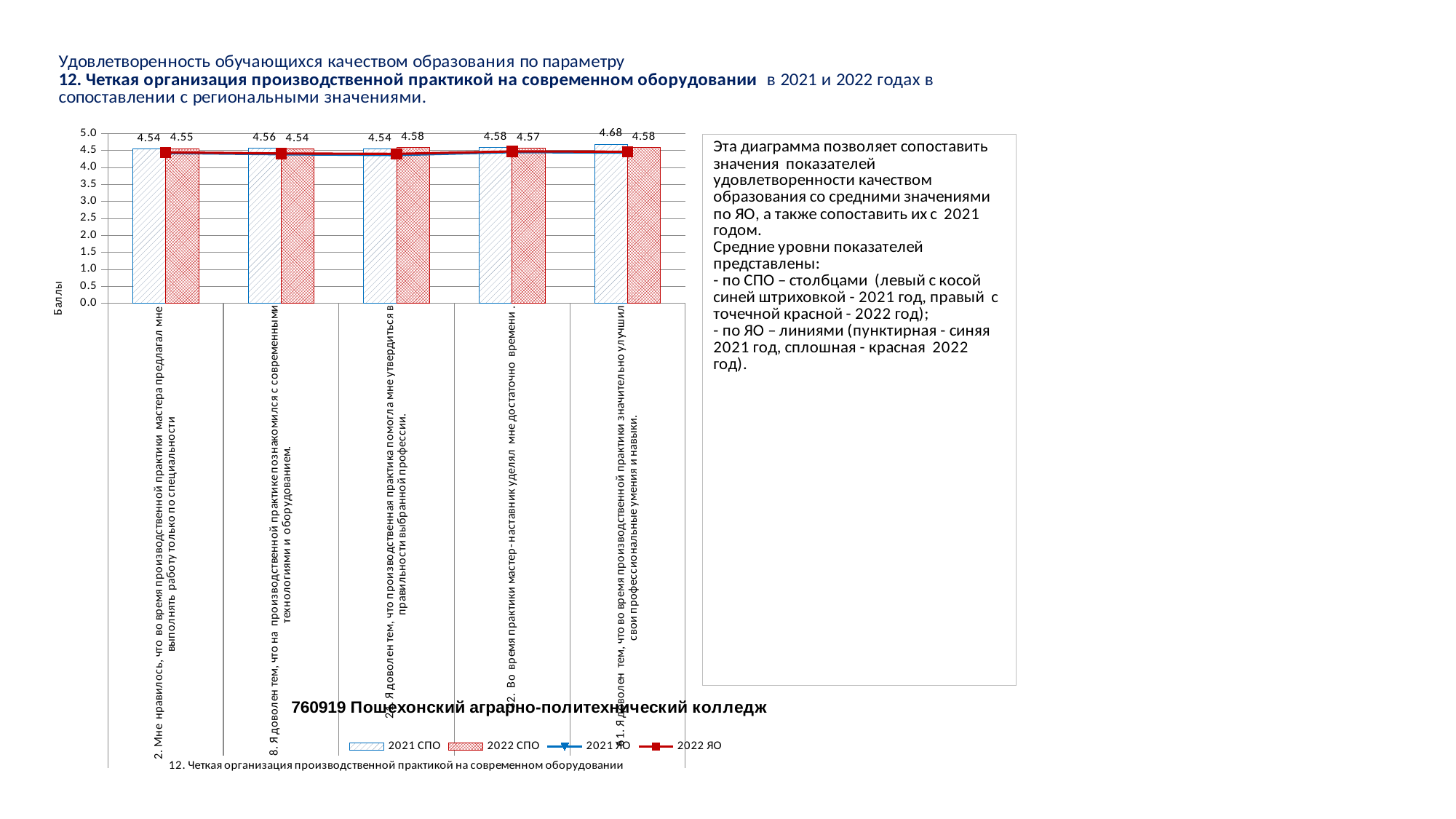
Which item has the highest 2021 СПО value? 61. Я доволен тем, что во время производственной практики значительно улучшил свои профессиональные умения и навыки What is the 2022 СПО value for item 2 (Мне нравилось, что во время производственной практики мастер предлагал мне выполнять работу только по специальности)? 4.55 What is the 2021 СПО value for item 8 (Я доволен тем, что на производственной практике познакомился с современными технологиями и оборудованием)? 4.56 Is the 2022 СПО value for item 32 greater or less than 4.0? greater Which item has the lowest 2022 СПО value? 8. Я доволен тем, что на производственной практике познакомился с современными технологиями и оборудованием How many series does the legend list? 4 How many items (categories) are shown on the x axis? 5 What is the 2021 СПО value for item 41 (Я доволен тем, что во время производственной практики значительно улучшил свои профессиональные умения и навыки)? 4.68 For item 41, which is larger: the 2021 СПО value or the 2022 СПО value? 2021 СПО What is the 2022 СПО value for item 22 (Я доволен тем, что производственная практика помогла мне утвердиться в правильности выбранной профессии)? 4.58 What is the difference between the 2021 СПО and 2022 СПО values for item 41? 0.10 What is the title of the vertical axis? Баллы